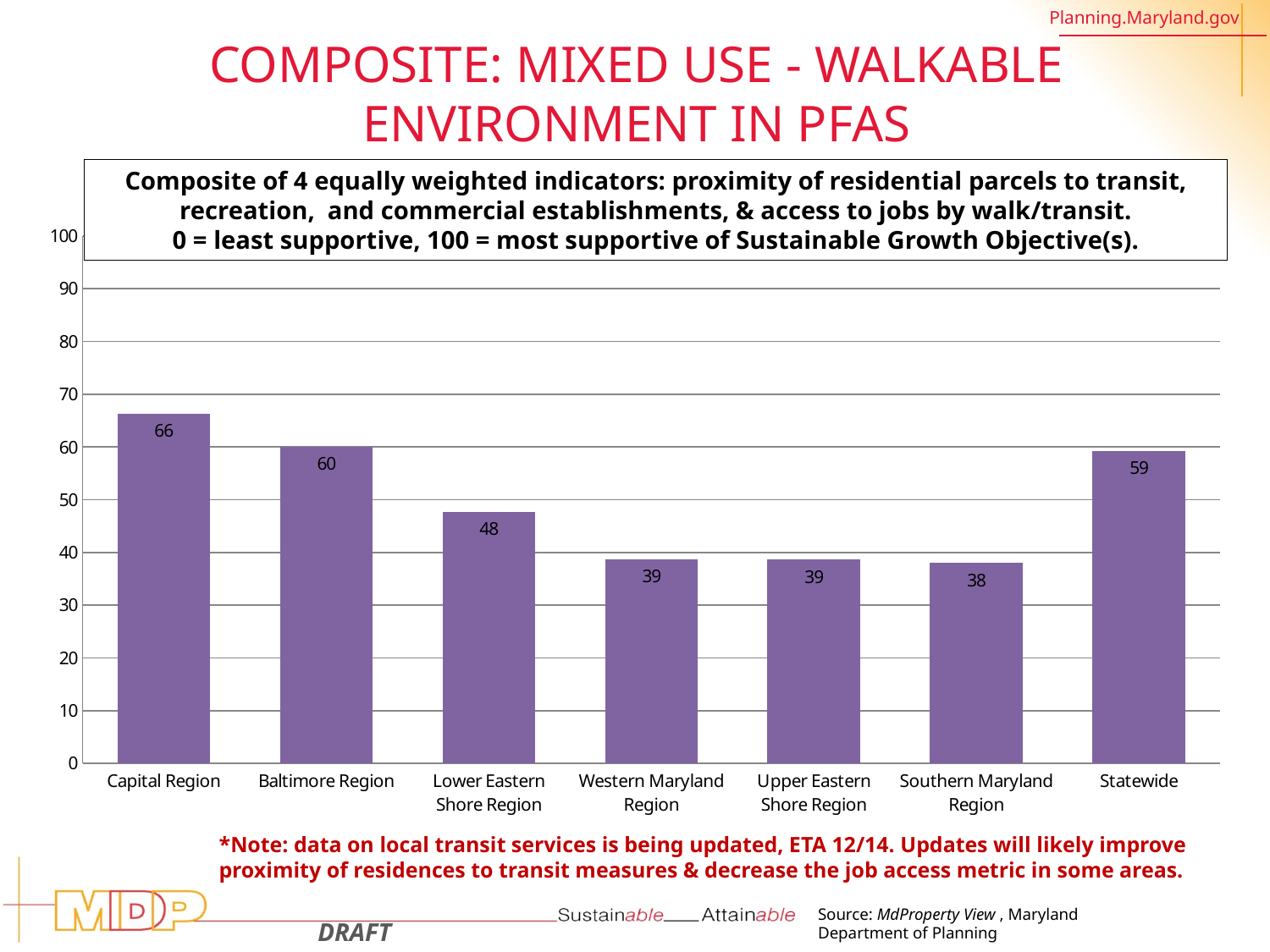
Which region has the highest value? Capital Region What kind of chart is shown on the slide? bar chart Which is larger, the value for Baltimore Region or the value for Statewide? Baltimore Region Which region has the lowest value? Southern Maryland Region What is the difference between the values for Capital Region and Baltimore Region? 6 Is the value for Western Maryland Region greater or less than 50? less What is the value for Statewide? 59 What is the difference between the values for Baltimore Region and Lower Eastern Shore Region? 12 What is the maximum value shown on the vertical axis? 100 How many bars are shown in the chart? 7 What is the value for Capital Region? 66 What is the value for Lower Eastern Shore Region? 48